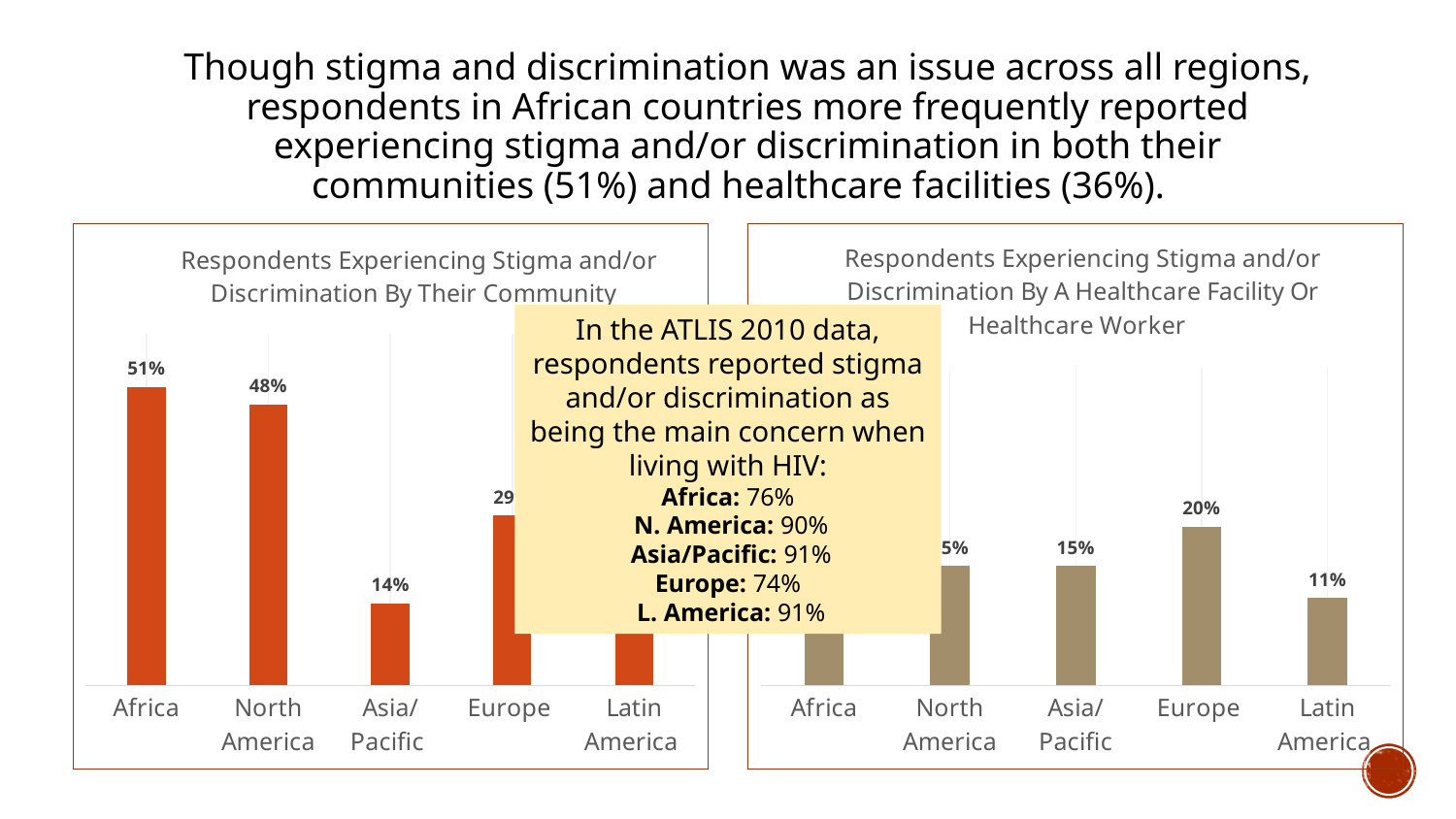
In the left chart (By Their Community), what is the difference between the values for Africa and North America? 3 percentage points In the left chart (By Their Community), which region has the highest value? Africa In the right chart (By A Healthcare Facility Or Healthcare Worker), which region has the lowest value? Latin America In the left chart (Respondents Experiencing Stigma and/or Discrimination By Their Community), what is the value for Africa? 51% In the right chart (By A Healthcare Facility Or Healthcare Worker), what is the value for Latin America? 11% In the right chart (By A Healthcare Facility Or Healthcare Worker), what is the value for Europe? 20% In the left chart (By Their Community), what is the value for North America? 48% In the right chart (By A Healthcare Facility Or Healthcare Worker), which is larger, the value for Europe or the value for Asia/Pacific? Europe In the right chart (By A Healthcare Facility Or Healthcare Worker), what is the value for Asia/Pacific? 15% In the left chart (By Their Community), what is the value for Asia/Pacific? 14% What type of chart is the right chart (By A Healthcare Facility Or Healthcare Worker)? Bar chart How many regions are shown on the x axis of the left chart (By Their Community)? 5